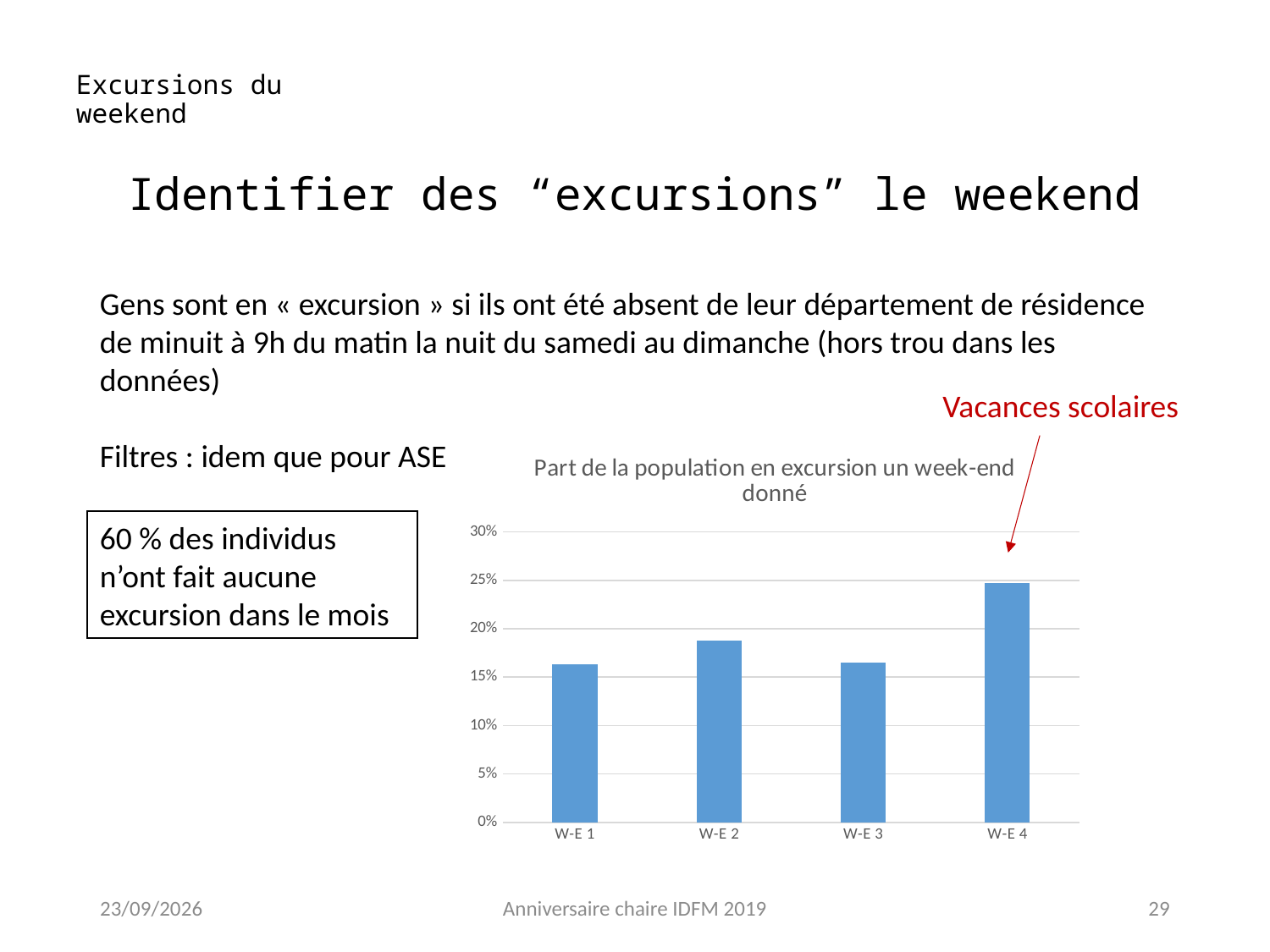
Is the value for W-E 3 greater or less than 20%? less Which is larger, the value for W-E 4 or the value for W-E 2? W-E 4 Which bar does the red annotation "Vacances scolaires" point to? W-E 4 Which is larger, the value for W-E 2 or the value for W-E 1? W-E 2 Is the value for W-E 3 greater or less than 15%? greater Is the value for W-E 1 greater or less than 20%? less Which weekend has the highest share of the population in excursion? W-E 4 What kind of chart is shown on the slide? bar chart How many weekends (categories) are plotted on the chart? 4 What is the title of the chart? Part de la population en excursion un week-end donné